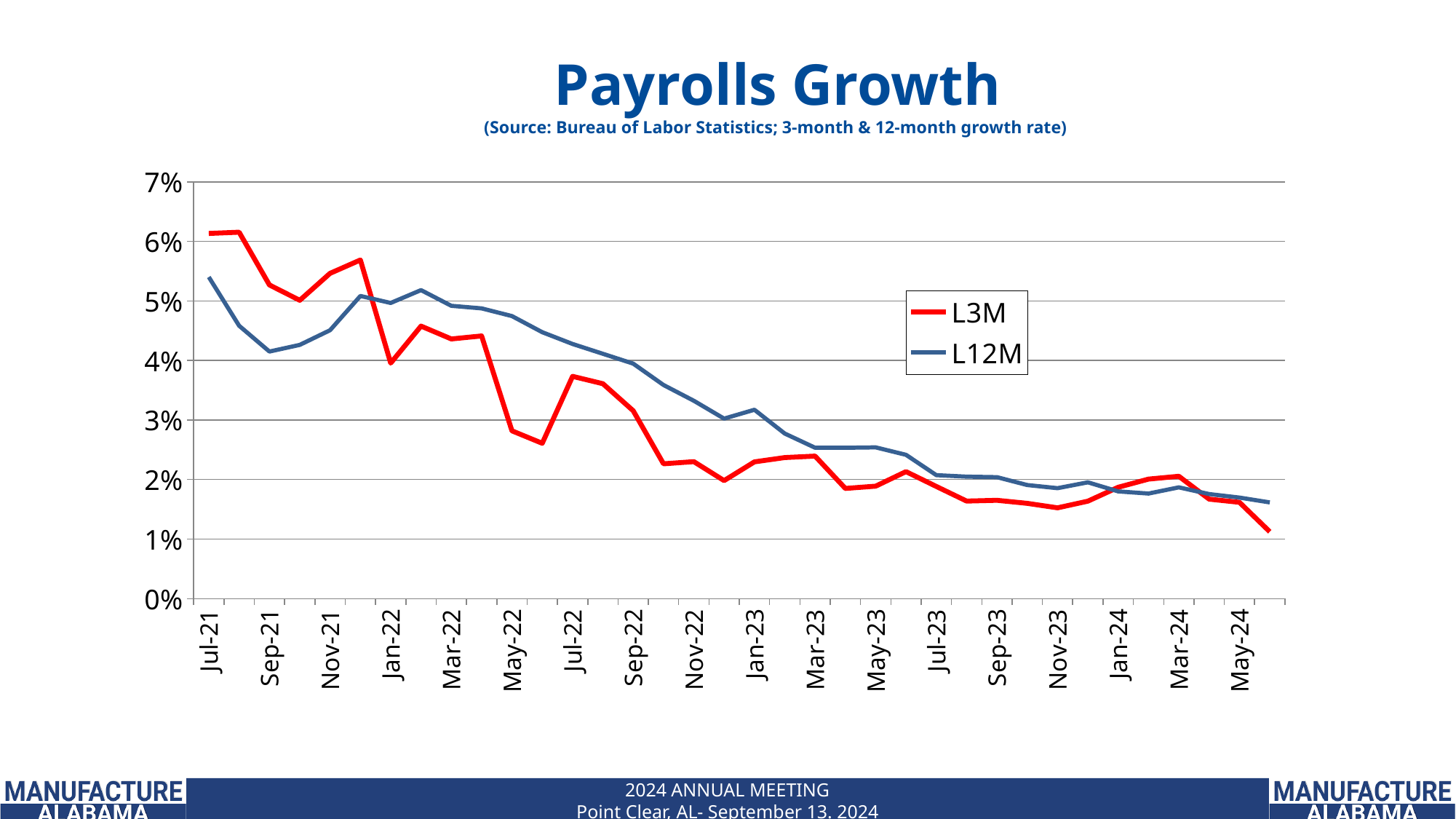
How many series does the legend list? 2 Is the L12M value at Nov-22 greater or less than 3%? greater Overall, do the L12M values rise or fall from Jul-21 to May-24? Fall At Jul-21, which series has the higher value, L3M or L12M? L3M What kind of chart is shown on the slide? Line chart At Mar-23, which series has the higher value, L3M or L12M? L12M Is the L3M value at Jul-21 greater or less than 5%? greater At which labeled month does the L12M series reach its highest value? Jul-21 Which series is drawn in red? L3M Is the L3M value at Nov-23 greater or less than 2%? less What is the title of the chart? Payrolls Growth